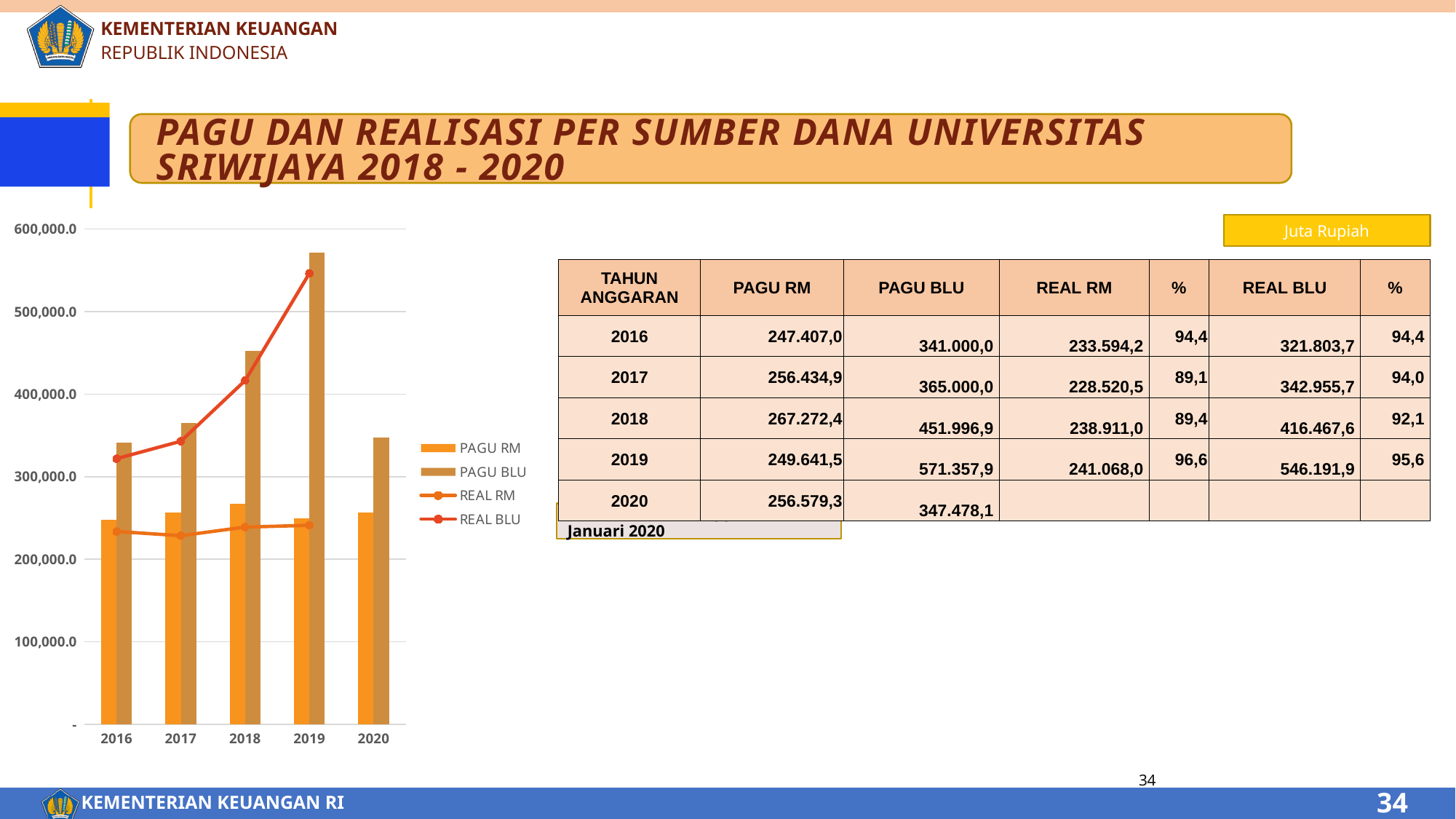
Is the REAL BLU value for 2018 greater or less than 400,000.0? greater How many series does the chart legend list? 4 In 2018, which is larger, PAGU BLU or PAGU RM? PAGU BLU What kind of chart is shown on the left of the slide? A combined bar and line chart Is the PAGU RM value for 2016 greater or less than 300,000.0? less According to the table, what is the REAL RM value for 2019? 241.068,0 Which series in the legend are drawn as lines rather than bars? REAL RM and REAL BLU In which year is the PAGU BLU bar the highest? 2019 Does the REAL BLU line rise or fall from 2016 to 2019? It rises According to the table, what is the PAGU BLU value for 2019? 571.357,9 How many years are shown on the x axis of the chart? 5 Is the PAGU BLU value for 2019 greater or less than 500,000.0? greater